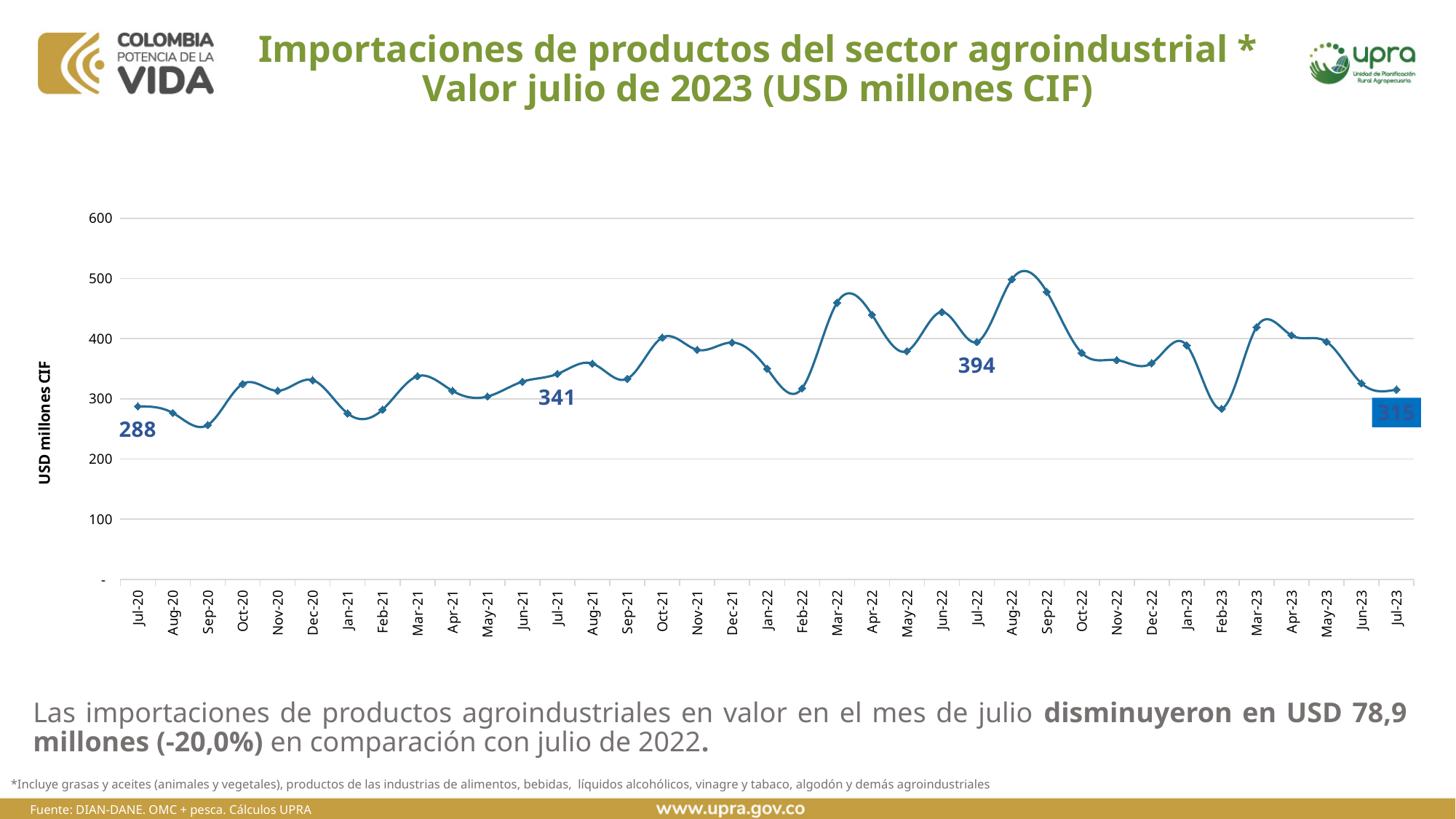
Is the value for Sep-20 greater or less than 300? less Is the value for Mar-22 greater or less than 400? greater What is the value for Jul-21? 341 What kind of chart is shown on the slide? line chart Which month has the highest value on the chart? Aug-22 What is the label on the vertical axis of the chart? USD millones CIF What is the value for Jul-23? 315 What is the value for Jul-22? 394 Which is larger, the value for Jul-22 or the value for Jul-23? Jul-22 How many monthly data points are plotted on the chart? 37 What is the difference between the values for Jul-22 and Jul-23? 79 What is the value for Jul-20? 288